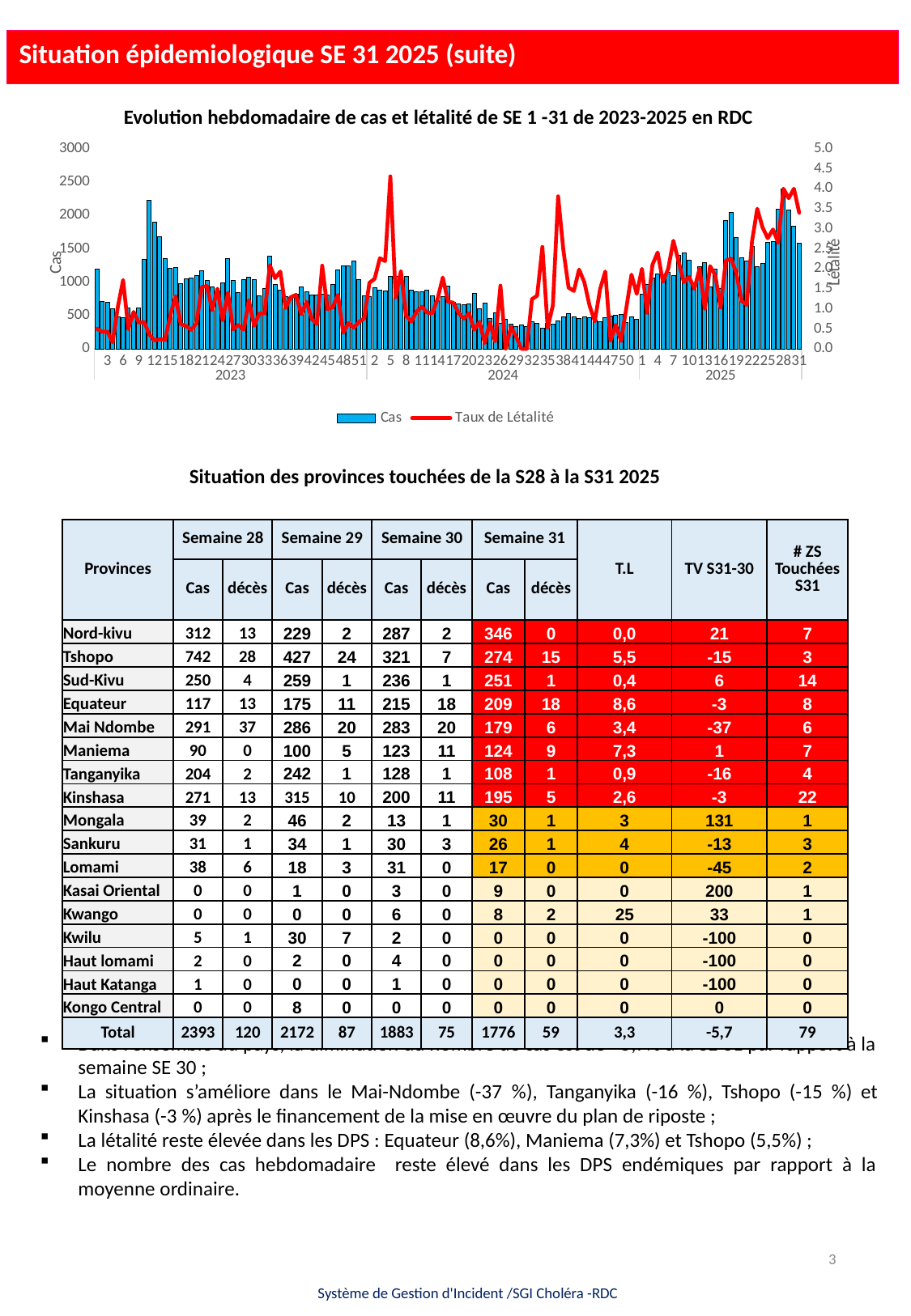
Is the number of cases around week 29 of 2024 greater or less than 500? less What are the two entries in the chart's legend? Cas and Taux de Létalité Is the number of cases at week 31 of 2025 greater or less than 2500? less What kind of chart is 'Evolution hebdomadaire de cas et létalité de SE 1 -31 de 2023-2025 en RDC'? A bar chart combined with a line chart Is the peak of the Taux de Létalité line in early 2024 (around week 5) greater or less than 4.0? greater Do the weekly case bars generally rise or fall from mid-2024 to week 31 of 2025? rise Which years are shown along the x axis of the chart? 2023, 2024 and 2025 How many series does the legend of the chart list? 2